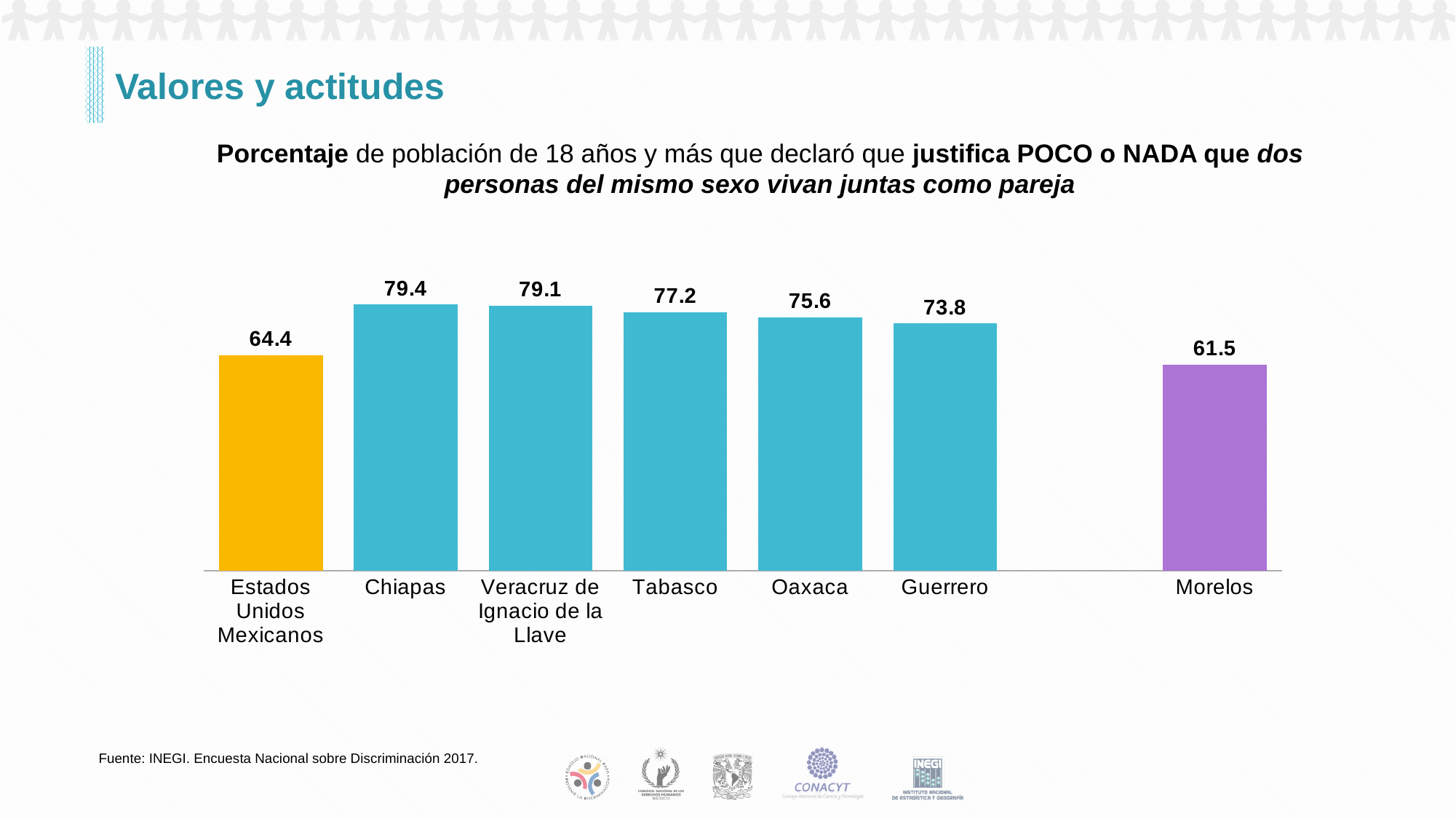
Which category has the lowest value? Morelos Which category has the highest value? Chiapas What kind of chart is shown on the slide? Bar chart Which is larger, the value for Veracruz de Ignacio de la Llave or the value for Oaxaca? Veracruz de Ignacio de la Llave What is the difference between the values for Chiapas and Morelos? 17.9 What is the value for Estados Unidos Mexicanos? 64.4 How many categories are shown in the chart? 7 What is the difference between the values for Tabasco and Guerrero? 3.4 What is the value for Morelos? 61.5 What colour is the bar for Morelos? Purple What is the value for Chiapas? 79.4 What is the value for Oaxaca? 75.6